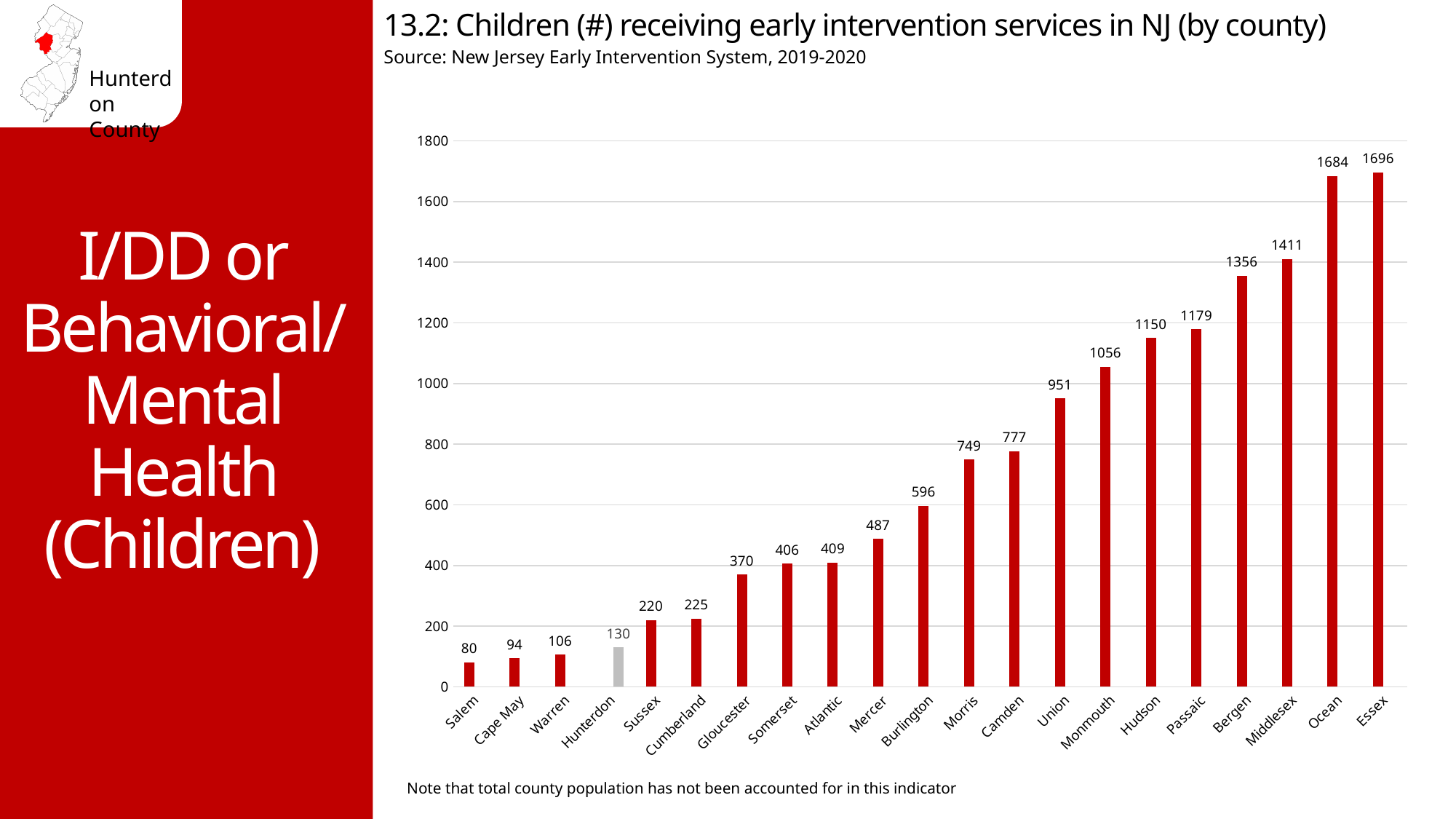
What is the difference between the values for Essex and Ocean? 12 Which county's bar is coloured grey instead of red? Hunterdon Do the values rise or fall moving from left to right along the x axis? Rise What is the difference between the values for Hunterdon and Salem? 50 Which county has the highest number of children receiving early intervention services? Essex What kind of chart is shown on the slide? Bar chart Is the value for Union greater or less than 1000? less What is the value shown for Mercer? 487 Which county has a larger value, Bergen or Middlesex? Middlesex How many children received early intervention services in Hunterdon County? 130 How many counties are shown on the chart? 21 Which county has the lowest number of children receiving early intervention services? Salem